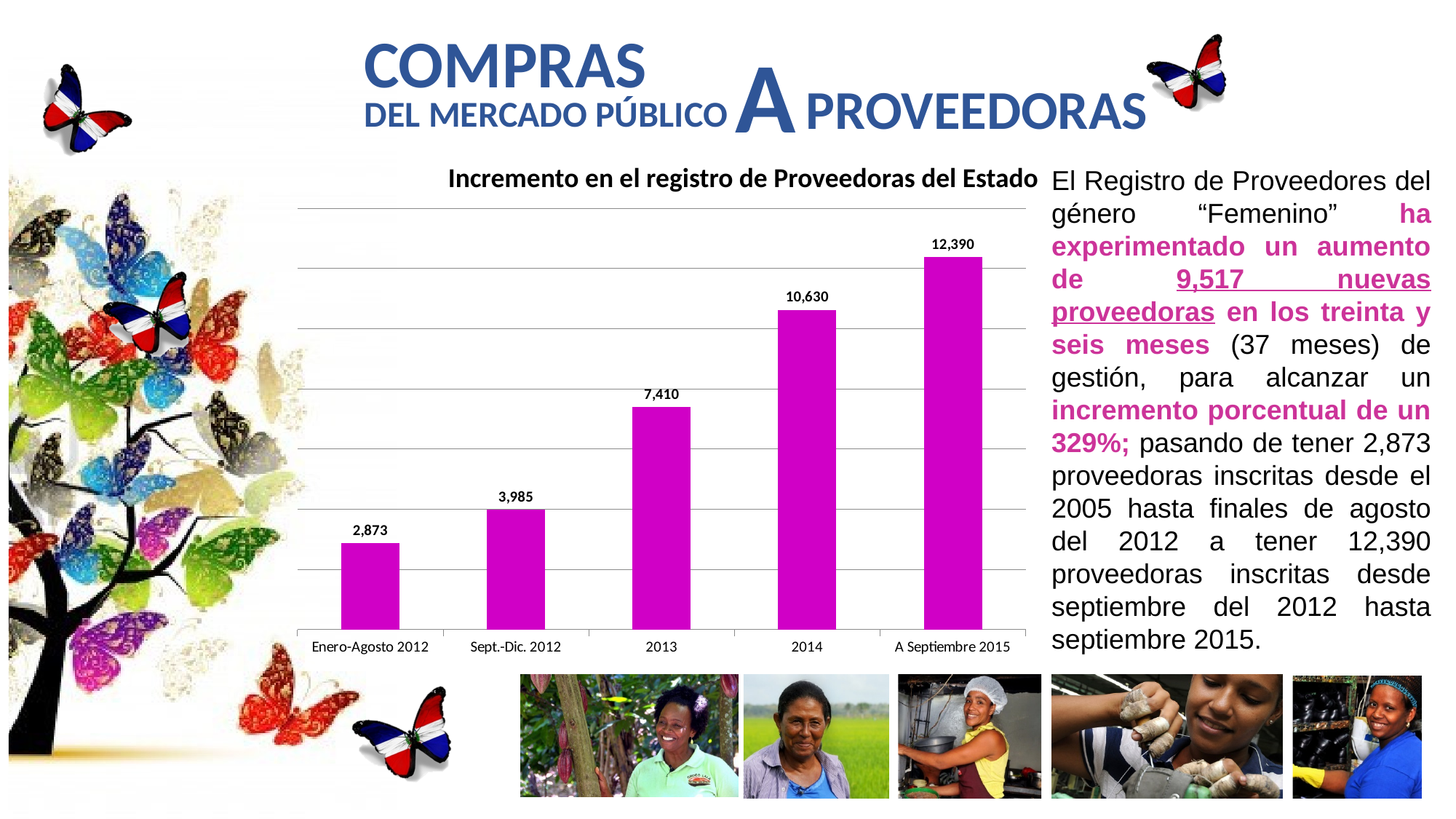
Which category has the lowest value? Enero-Agosto 2012 What is the value for Sept.-Dic. 2012? 3,985 What kind of chart is shown on the slide? Bar chart How many categories are shown on the x axis? 5 What is the value for A Septiembre 2015? 12,390 Which category has the highest value? A Septiembre 2015 Which is larger, the value for 2014 or the value for Sept.-Dic. 2012? 2014 What is the value for 2013 in the chart? 7,410 What is the difference between the values for 2014 and 2013? 3,220 Do the values rise or fall from left to right along the x axis? Rise What is the difference between the values for A Septiembre 2015 and Enero-Agosto 2012? 9,517 What is the value for Enero-Agosto 2012? 2,873